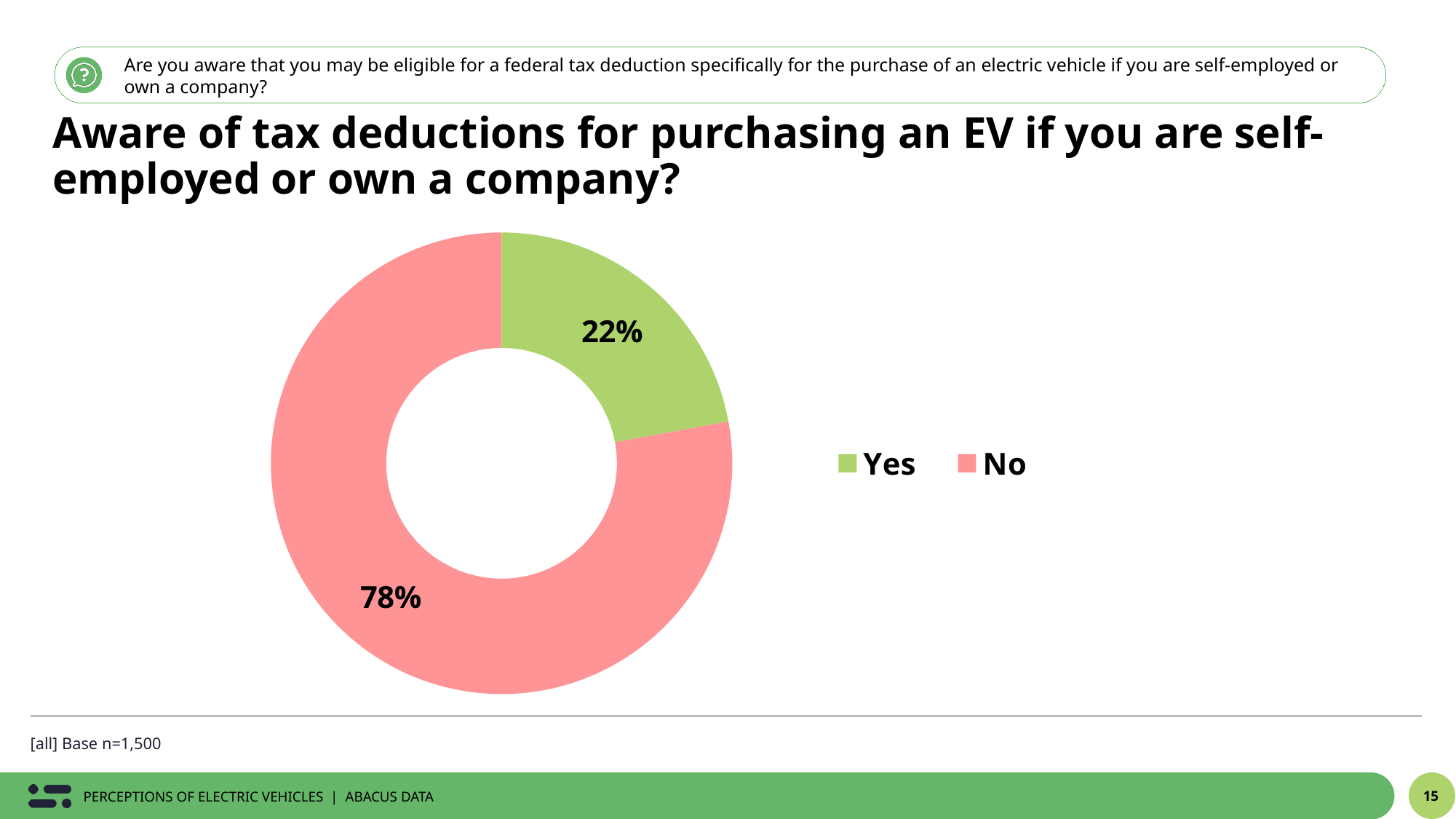
What is the difference in percentage points between the No and Yes shares? 56 What percentage of respondents answered No? 78% Which response has the largest share of the chart? No What kind of chart is shown on the slide? Pie chart (doughnut) How many categories does the chart show? 2 Which is larger, the share for Yes or the share for No? No Which response has the smallest share of the chart? Yes What share of the pie does the Yes slice represent? 22% What percentage of respondents answered Yes? 22% How many entries does the legend list? 2 What colour is the No slice? Pink What is the base sample size noted below the chart? n=1,500